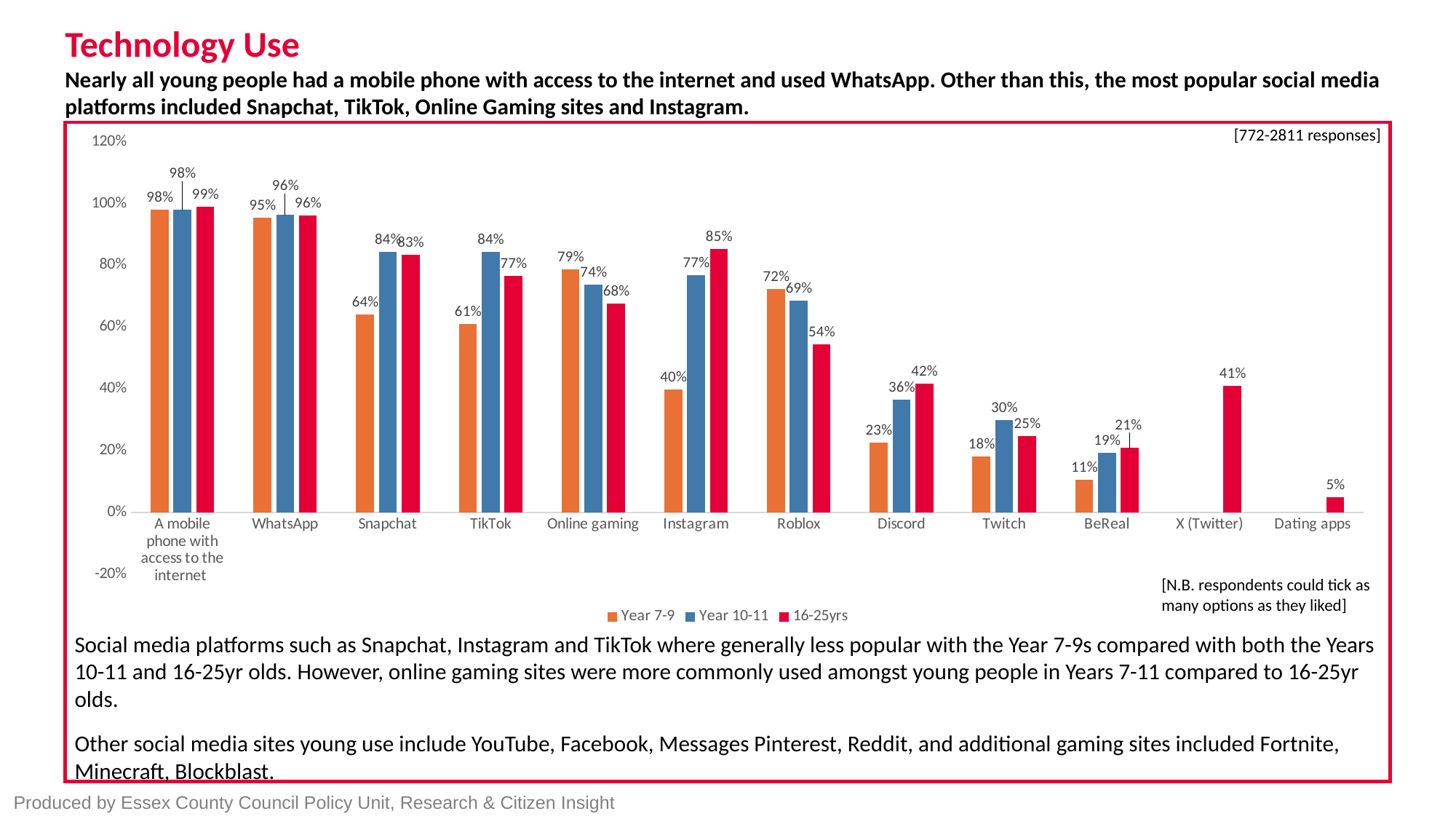
How many categories are shown along the x axis? 12 Which category has the lowest value for 16-25yrs? Dating apps What is the value for Year 7-9 for Instagram? 40% Which category has the highest value for Year 7-9? A mobile phone with access to the internet How many series does the legend list? 3 What is the difference between the 16-25yrs and Year 7-9 values for Instagram? 45% What is the value for Year 10-11 for Discord? 36% What is the difference between the Year 10-11 and Year 7-9 values for Snapchat? 20% What is the value for 16-25yrs for X (Twitter)? 41% Which series is shown in orange in the legend? Year 7-9 What kind of chart is shown on the slide? bar chart For Online gaming, which is larger: the Year 7-9 value or the 16-25yrs value? Year 7-9